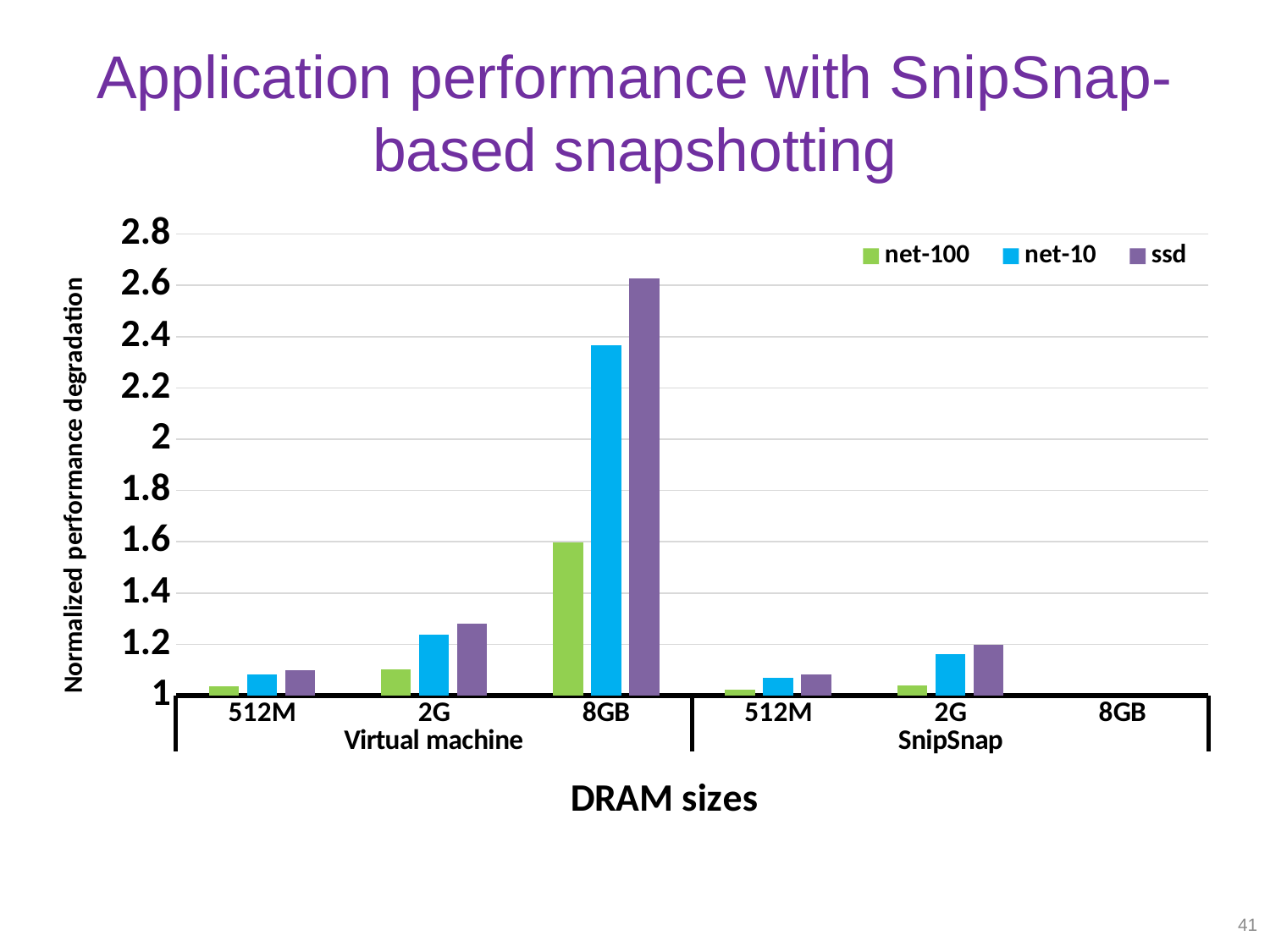
For 8GB under Virtual machine, which is larger, the net-10 value or the net-100 value? net-10 Is the net-100 value for 2G under Virtual machine greater or less than 1.2? less Which is larger, the ssd value for 8GB under Virtual machine or the ssd value for 2G under SnipSnap? 8GB under Virtual machine What is the title of the x axis? DRAM sizes Within the Virtual machine group, do the ssd values rise or fall from 512M to 8GB? rise Is the ssd value for 8GB under Virtual machine greater or less than 2.4? greater What are the series names listed in the legend? net-100, net-10, ssd What kind of chart is shown on the slide? bar chart How many series does the legend list? 3 Which DRAM size group has the tallest ssd bar? 8GB under Virtual machine Is the net-100 value for 8GB under Virtual machine greater or less than 1.8? less